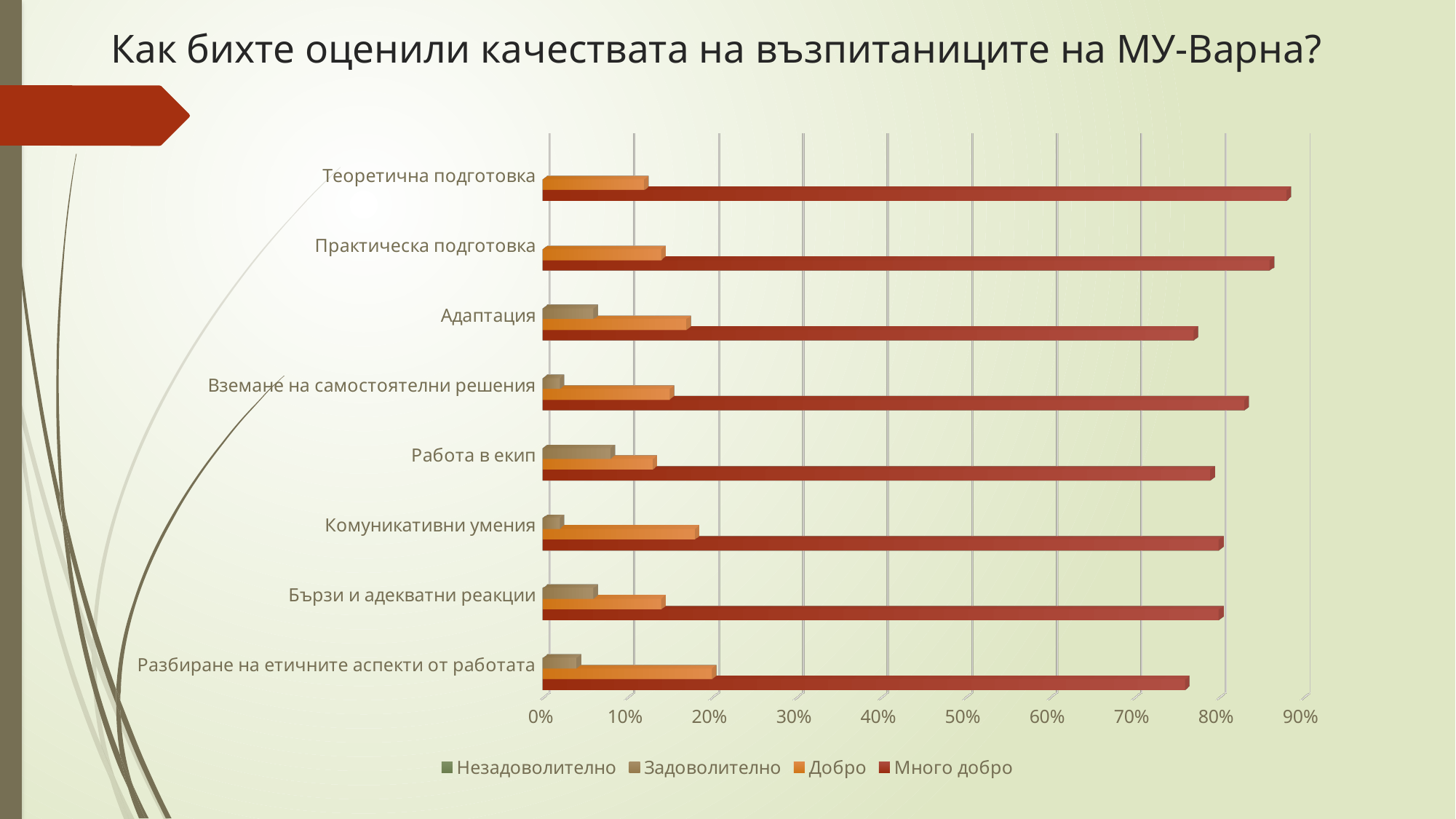
How many series does the chart legend list? 4 Is the 'Много добро' value for 'Адаптация' greater or less than 80%? less Which category has the highest value for the 'Много добро' series? Теоретична подготовка Is the 'Задоволително' value for 'Работа в екип' greater or less than 10%? less Is the 'Добро' value for 'Разбиране на етичните аспекти от работата' greater or less than 10%? greater What is the title of the slide containing the chart? Как бихте оценили качествата на възпитаниците на МУ-Варна? What kind of chart is shown on the slide? Bar chart Which is larger: the 'Много добро' value for 'Теоретична подготовка' or for 'Адаптация'? Теоретична подготовка Which is larger: the 'Добро' value for 'Разбиране на етичните аспекти от работата' or for 'Теоретична подготовка'? Разбиране на етичните аспекти от работата How many categories (qualities) are listed on the vertical axis of the chart? 8 Which series is shown in dark red in the chart legend? Много добро